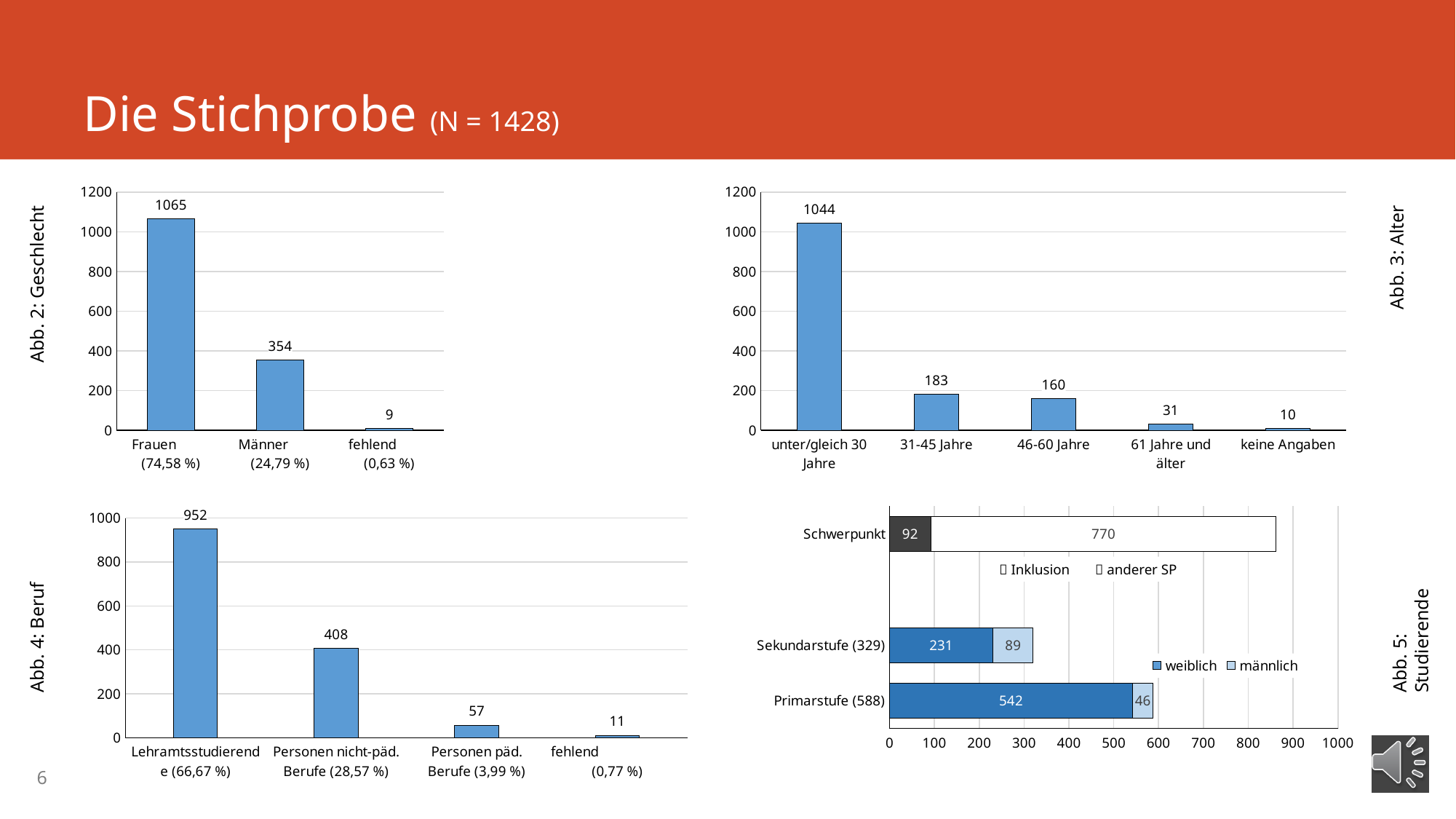
In the chart 'Abb. 4: Beruf', what percentage is shown for Lehramtsstudierende? 66,67 % In the chart 'Abb. 2: Geschlecht', what is the value for Männer? 354 In the chart 'Abb. 4: Beruf', what is the value for Personen nicht-päd. Berufe? 408 In the chart 'Abb. 5: Studierende', what is the value for männlich in Sekundarstufe? 89 In the chart 'Abb. 3: Alter', which age category has the highest value? unter/gleich 30 Jahre What kind of chart is 'Abb. 5: Studierende'? Bar chart In the chart 'Abb. 3: Alter', which is larger, the value for 61 Jahre und älter or the value for keine Angaben? 61 Jahre und älter In the chart 'Abb. 4: Beruf', which category has the lowest value? fehlend In the chart 'Abb. 5: Studierende', what is the total of the Primarstufe bar (weiblich plus männlich)? 588 In the chart 'Abb. 2: Geschlecht', what is the difference between the values for Frauen and Männer? 711 In the chart 'Abb. 3: Alter', how many categories are shown on the x axis? 5 In the chart 'Abb. 3: Alter', what is the value for 46-60 Jahre? 160